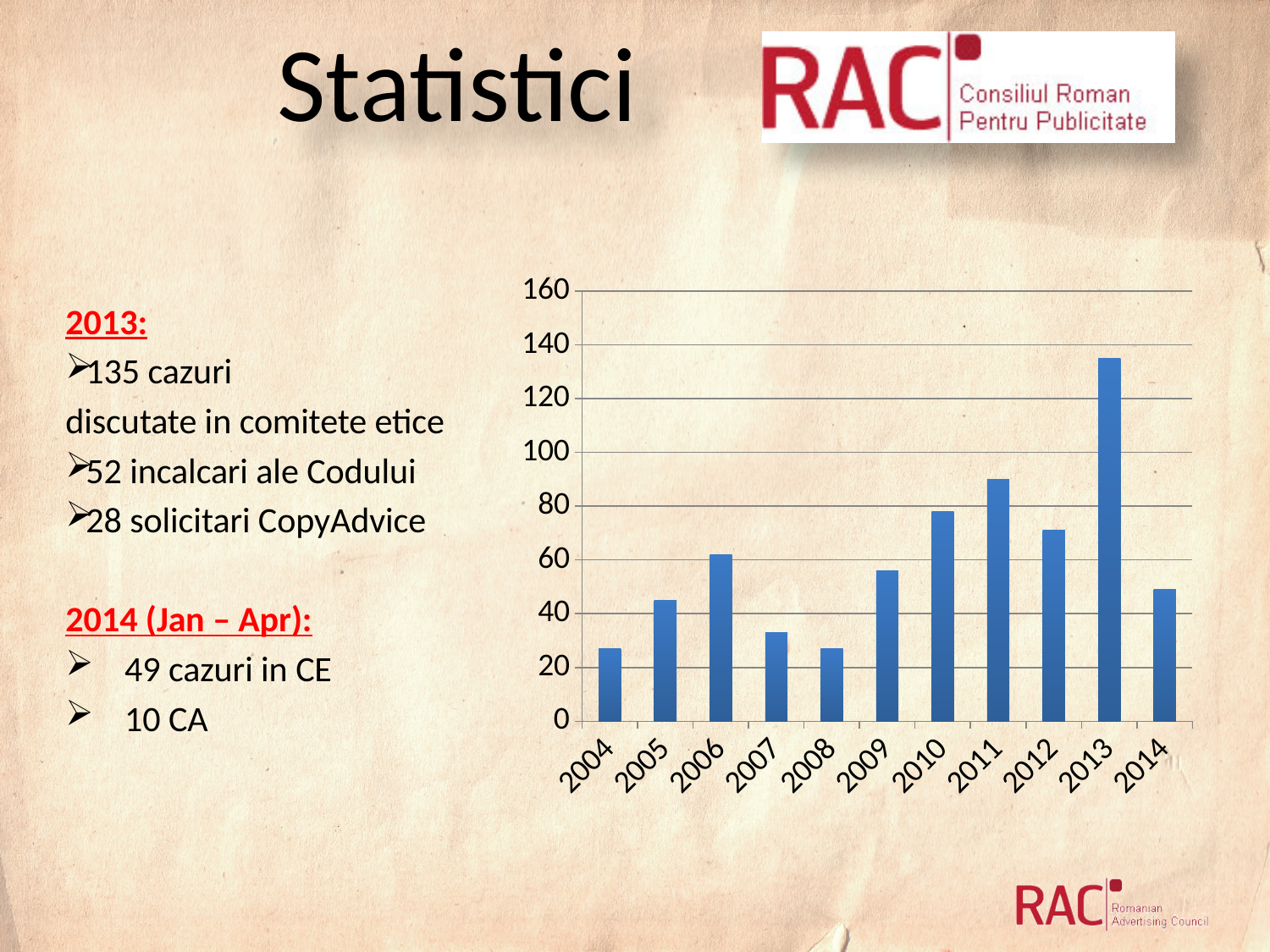
Which is larger, the value for 2011 or the value for 2010? 2011 How many years are shown on the x axis of the chart? 11 Which is larger, the value for 2006 or the value for 2007? 2006 Do the values rise or fall from 2009 to 2011? rise Is the value for 2010 greater or less than 60? greater Is the value for 2004 greater or less than 40? less Is the value for 2014 greater or less than 40? greater Which year has the highest bar in the chart? 2013 What kind of chart is shown on the slide? bar chart